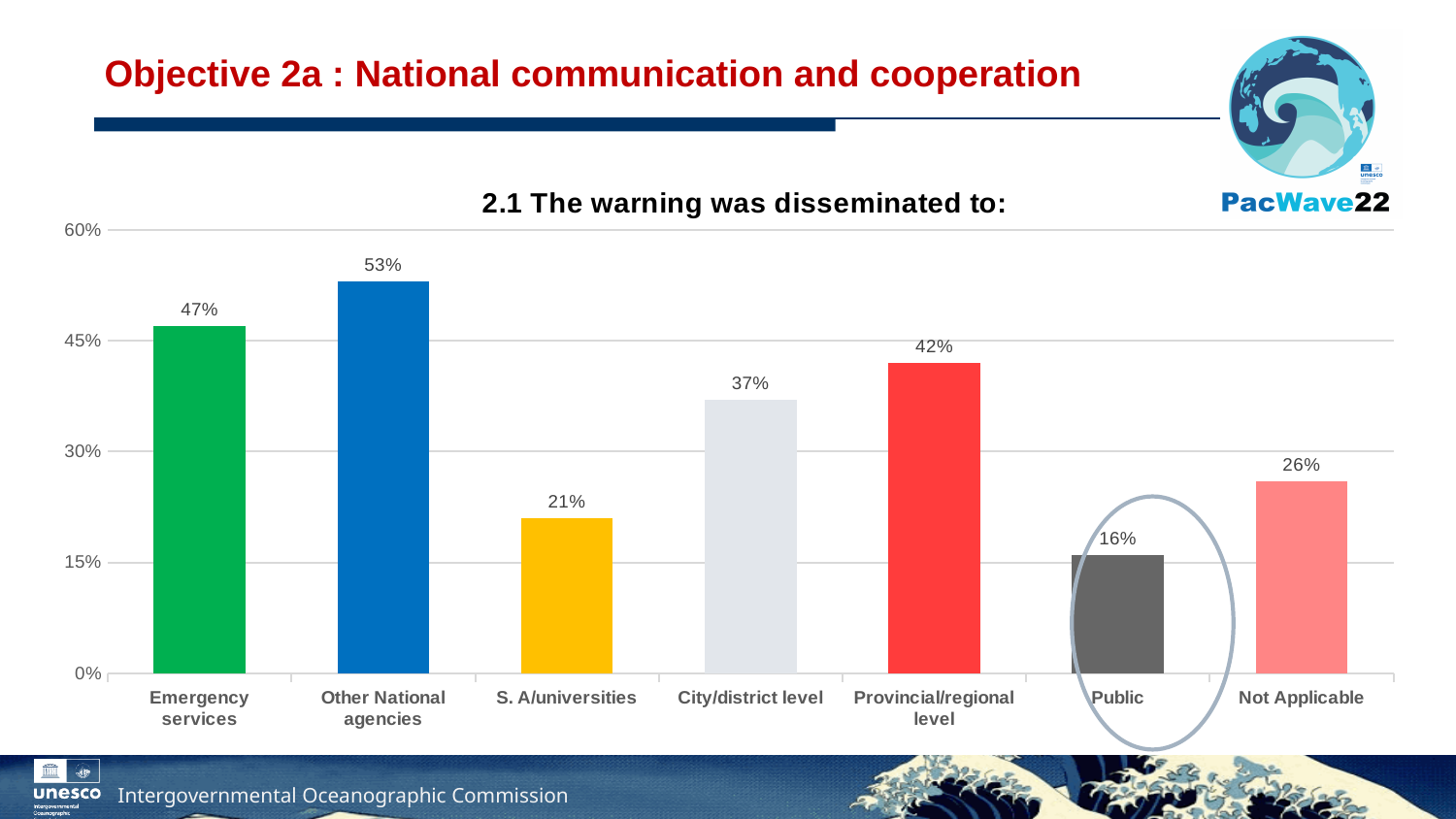
What kind of chart is shown on the slide? Bar chart What is the value shown for Public? 16% What is the difference between the values for Other National agencies and Emergency services? 6% Which category has the highest value? Other National agencies What is the title of the chart? 2.1 The warning was disseminated to: What is the value shown for Other National agencies? 53% Which category has the lowest value? Public What percentage of respondents disseminated the warning to Emergency services? 47% What is the value shown for Not Applicable? 26% What is the difference between the values for Provincial/regional level and City/district level? 5% How many categories are shown on the x axis? 7 Which is larger, the value for S. A/universities or the value for Not Applicable? Not Applicable